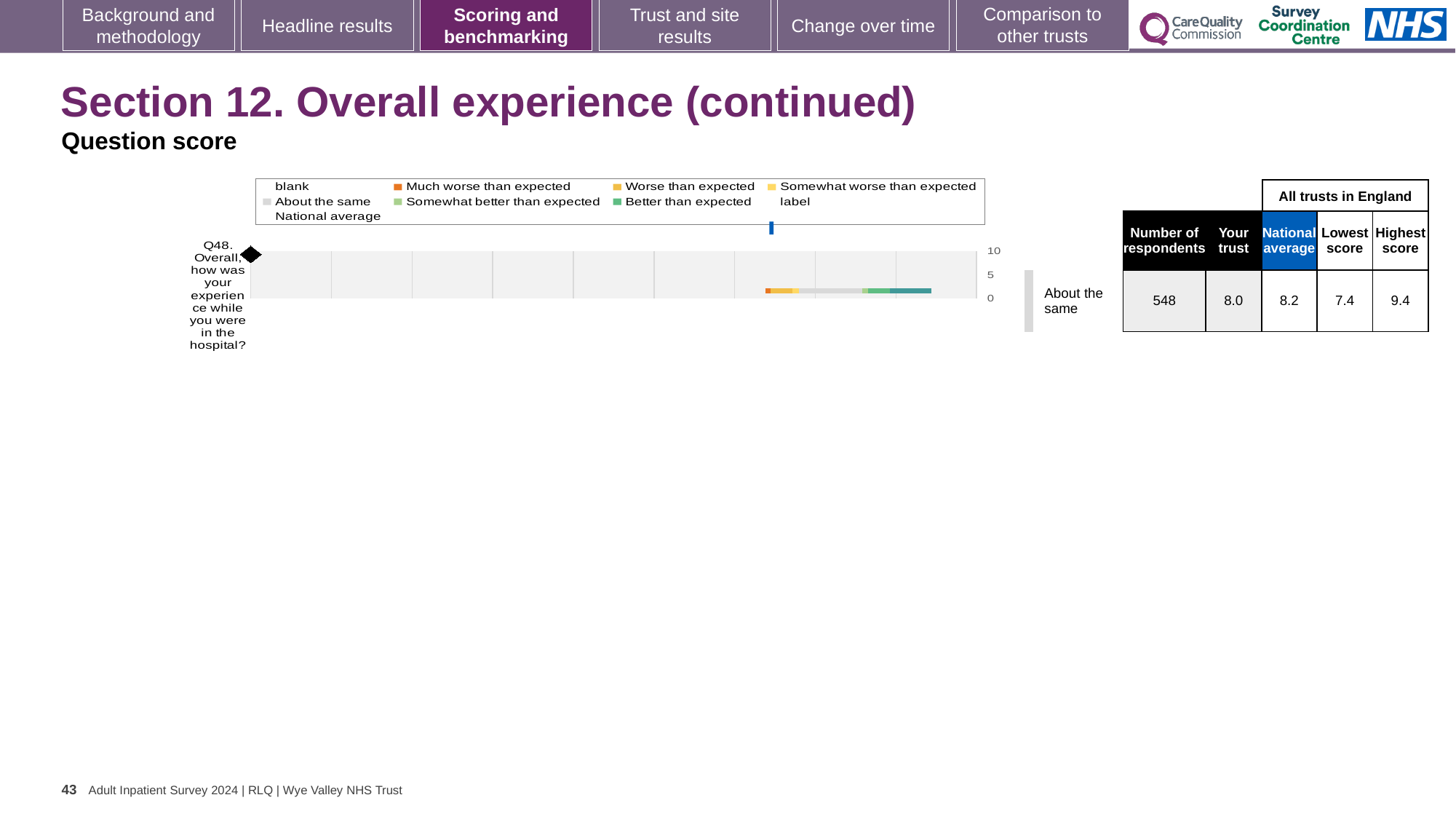
Which question is plotted on the chart? Q48. Overall, how was your experience while you were in the hospital? What kind of chart is shown on the slide? bar chart Which is larger for Q48: the 'Your trust' score or the national average? National average According to the table beside the chart, how many respondents answered Q48? 548 According to the table beside the chart, what is the national average score for Q48? 8.2 According to the table beside the chart, what is the lowest score among all trusts in England for Q48? 7.4 According to the table beside the chart, what is the highest score among all trusts in England for Q48? 9.4 What benchmark category is the trust's Q48 score placed in, as labelled next to the chart? About the same According to the table beside the chart, what is the 'Your trust' score for Q48? 8.0 What is the highest tick value shown on the chart's axis? 10 What is the difference between the highest score (9.4) and the lowest score (7.4) for Q48 in the table? 2.0 How many questions (categories) are plotted on the chart? 1